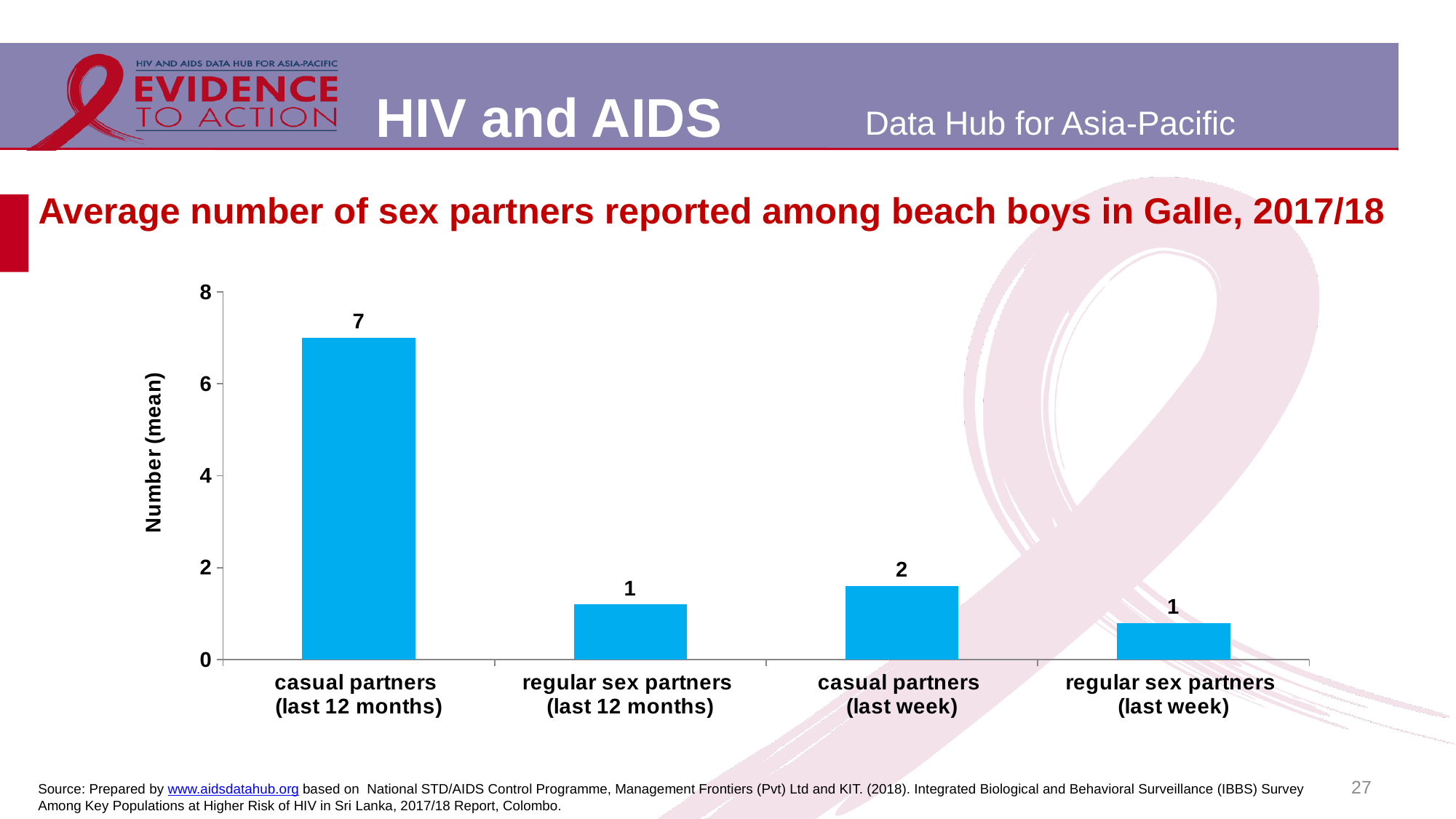
What is the average number of casual partners (last 12 months) reported among beach boys in Galle? 7 What is the label of the vertical axis? Number (mean) What kind of chart is shown on the slide? bar chart Is the value for casual partners (last 12 months) greater or less than 6? greater What is the difference between the values for casual partners (last 12 months) and casual partners (last week)? 5 How many categories are shown on the chart? 4 Which is larger: the value for casual partners (last week) or regular sex partners (last 12 months)? casual partners (last week) Which category has the highest average number of sex partners? casual partners (last 12 months) What is the difference between the values for casual partners (last 12 months) and regular sex partners (last 12 months)? 6 What value is shown for regular sex partners (last 12 months)? 1 What is the average number of casual partners (last week) shown on the chart? 2 Is the value for casual partners (last week) greater or less than 4? less